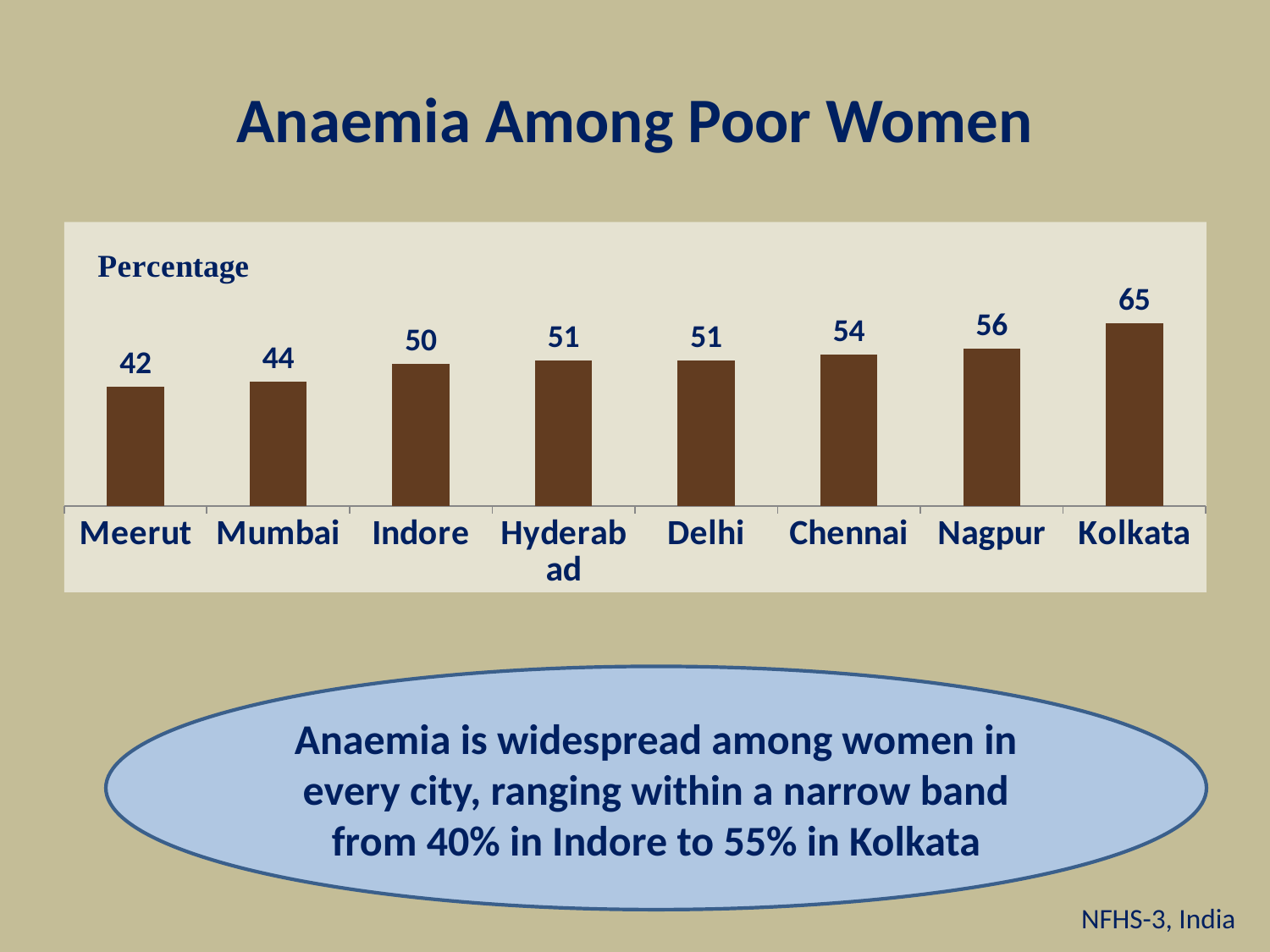
What is the value shown for Chennai? 54 Which has a higher value, Chennai or Indore? Chennai What is the title of the slide containing the chart? Anaemia Among Poor Women Do the values generally rise or fall from left to right across the cities? Rise What is the difference between the values for Kolkata and Meerut? 23 What is the value shown for Kolkata? 65 Which city has the lowest percentage of anaemia among poor women? Meerut How many cities are shown in the chart? 8 What is the difference between the values for Nagpur and Mumbai? 12 What type of chart is shown on the slide? Bar chart What is the percentage of anaemia among poor women in Meerut? 42 Which city has the highest percentage of anaemia among poor women? Kolkata